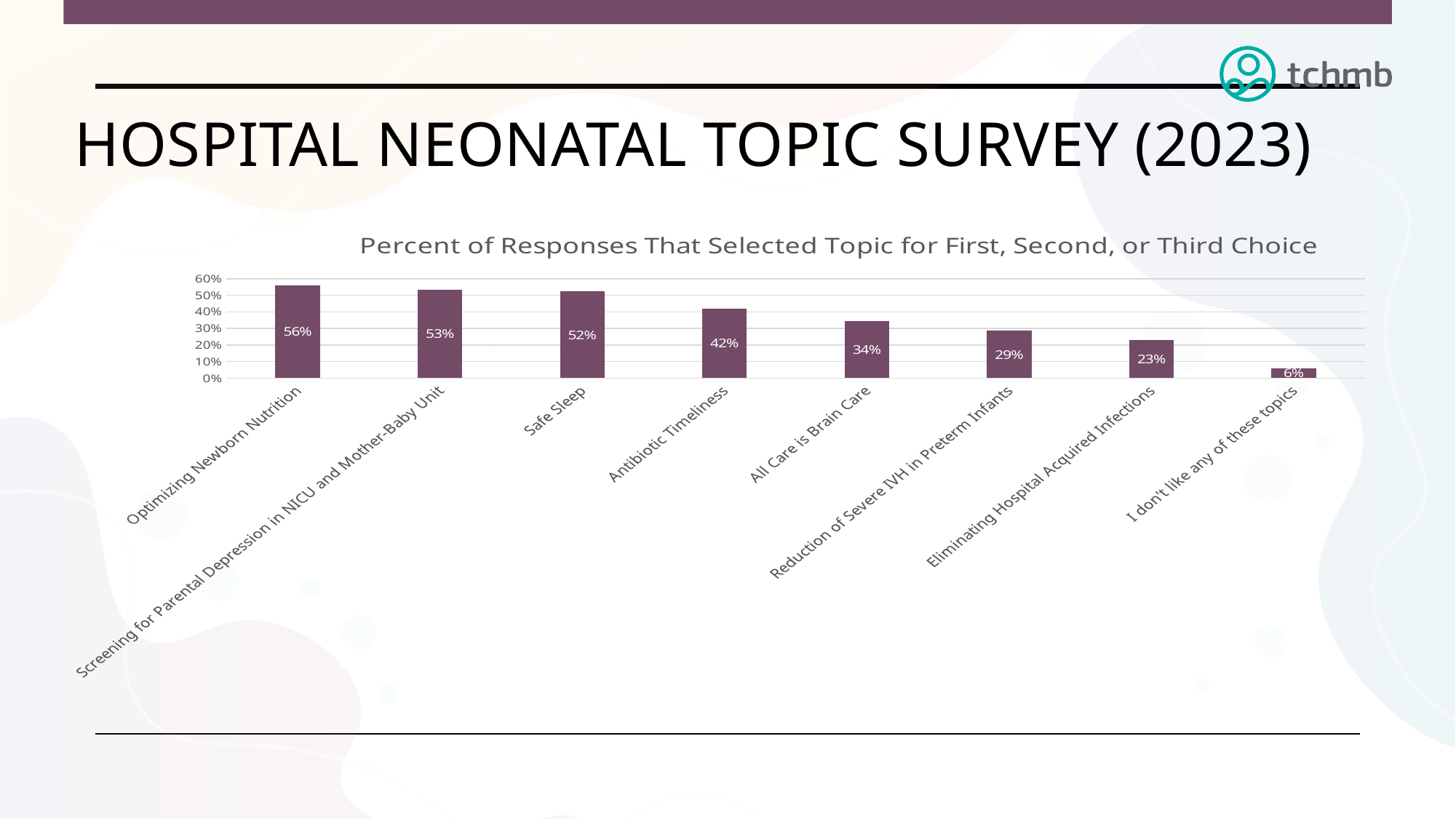
What is the value shown for Antibiotic Timeliness? 42% What is the difference between the values for Safe Sleep and All Care is Brain Care? 18% Which topic has the highest percent of responses? Optimizing Newborn Nutrition What kind of chart is shown on the slide? Bar chart Do the values rise or fall from left to right along the x axis? Fall How many categories are shown on the chart? 8 Which category has the lowest percent of responses? I don't like any of these topics What is the title of the chart? Percent of Responses That Selected Topic for First, Second, or Third Choice What is the value shown for Eliminating Hospital Acquired Infections? 23% What percent of responses selected Optimizing Newborn Nutrition as a first, second, or third choice? 56% Which is larger, the value for Antibiotic Timeliness or the value for Reduction of Severe IVH in Preterm Infants? Antibiotic Timeliness What is the value shown for Reduction of Severe IVH in Preterm Infants? 29%